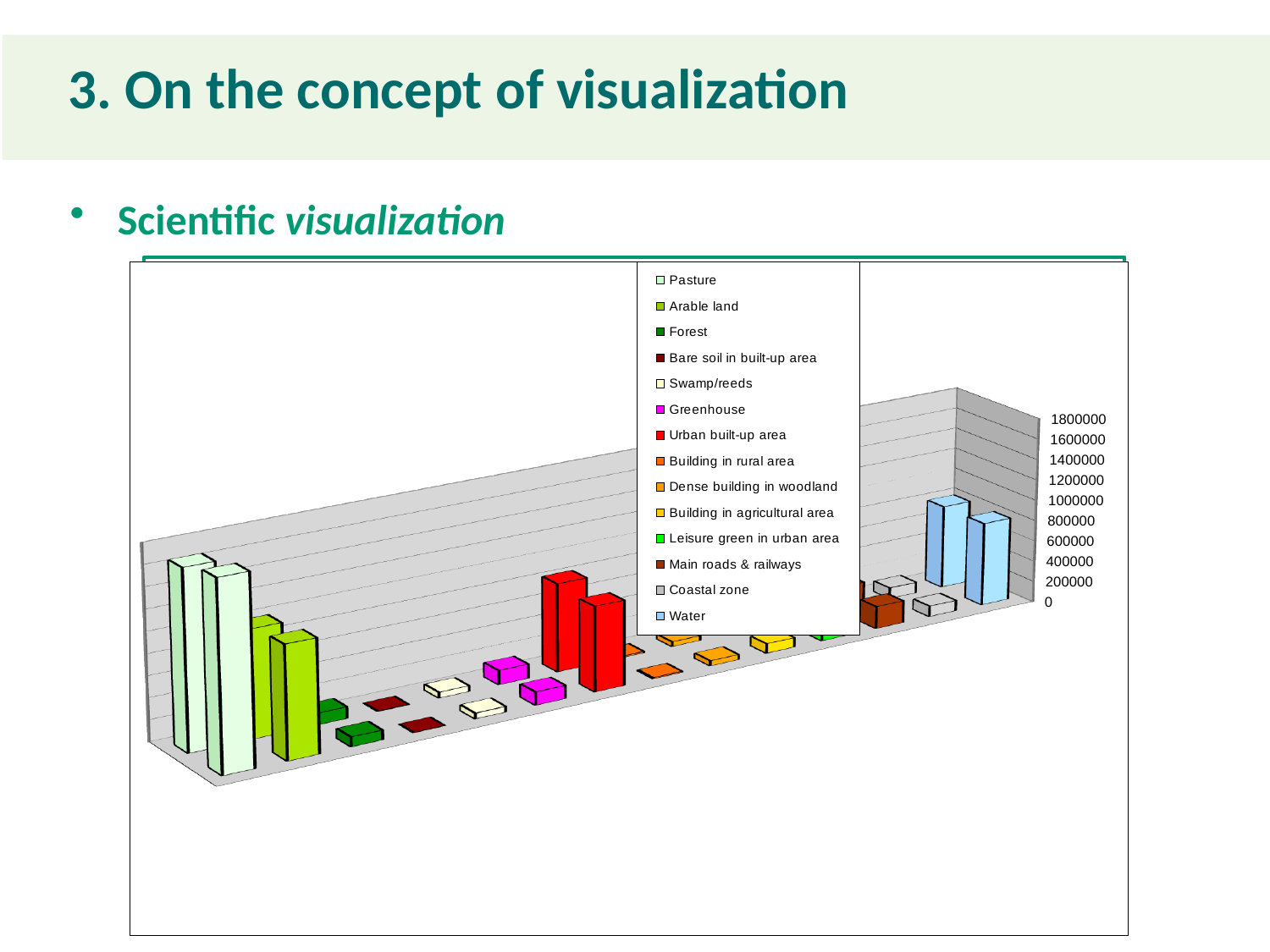
Which series has taller bars, Arable land or Bare soil in built-up area? Arable land Is the value of the tallest Pasture bar greater or less than 1000000? greater How many bars are plotted for the Pasture series? 2 Which series has the tallest bars in the chart? Pasture Which series has taller bars, Water or Coastal zone? Water Which series has taller bars, Pasture or Forest? Pasture What is the highest tick value shown on the chart's value axis? 1800000 How many series does the chart's legend list? 14 What kind of chart is shown on the slide? bar chart What colour represents the Urban built-up area series in the legend? red